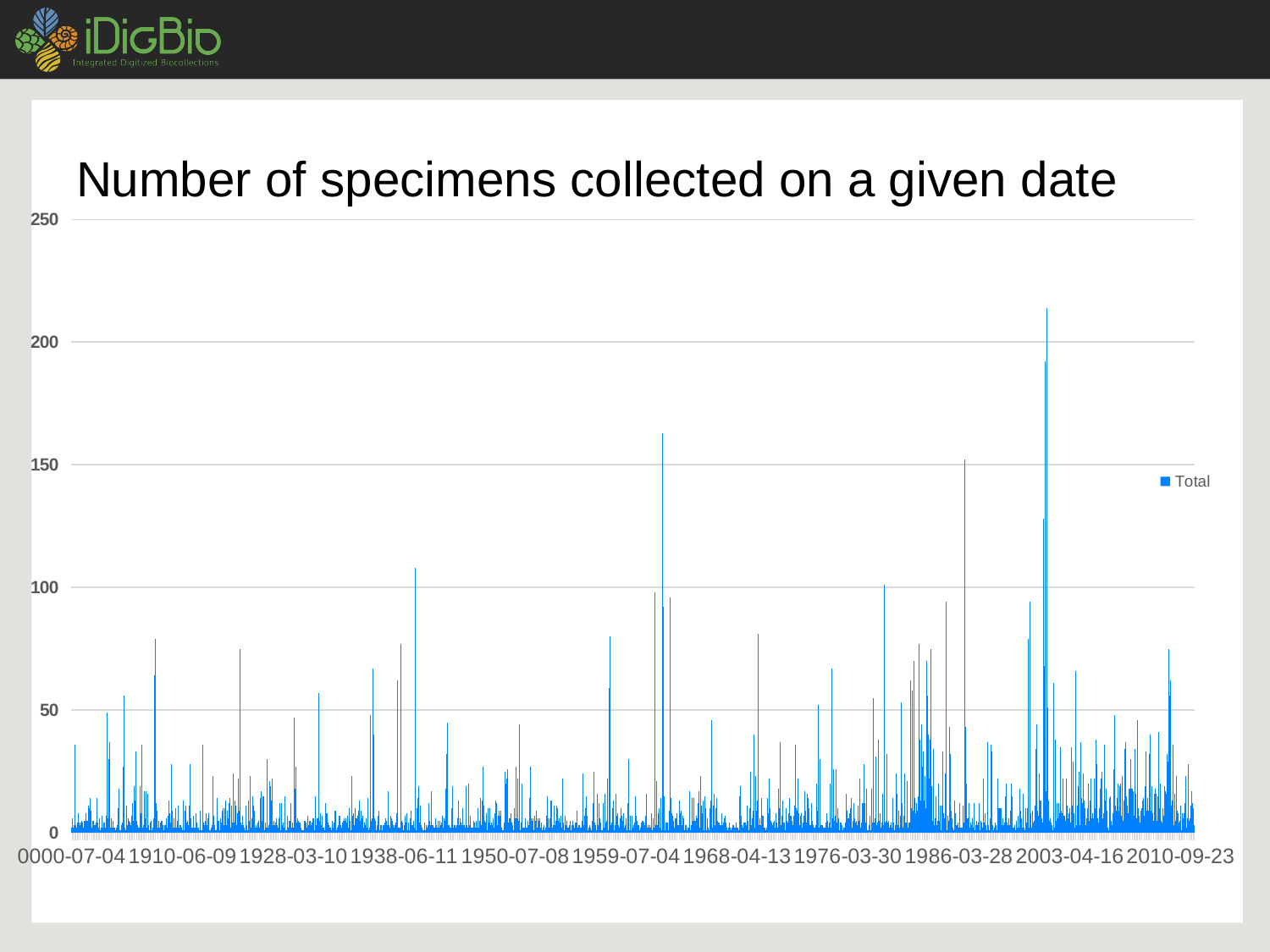
What is the highest value shown on the vertical axis? 250 Is the value of the tallest bar between the 1959-07-04 and 1968-04-13 labels greater or less than 150? greater What is the name of the series shown in the legend? Total What kind of chart is shown on the slide? bar chart Is the value of the tallest bar between the 1938-06-11 and 1950-07-08 labels greater or less than 150? less Is the value of the tallest bar on the chart greater or less than 200? greater How many series does the legend list? 1 What is the title of the chart? Number of specimens collected on a given date